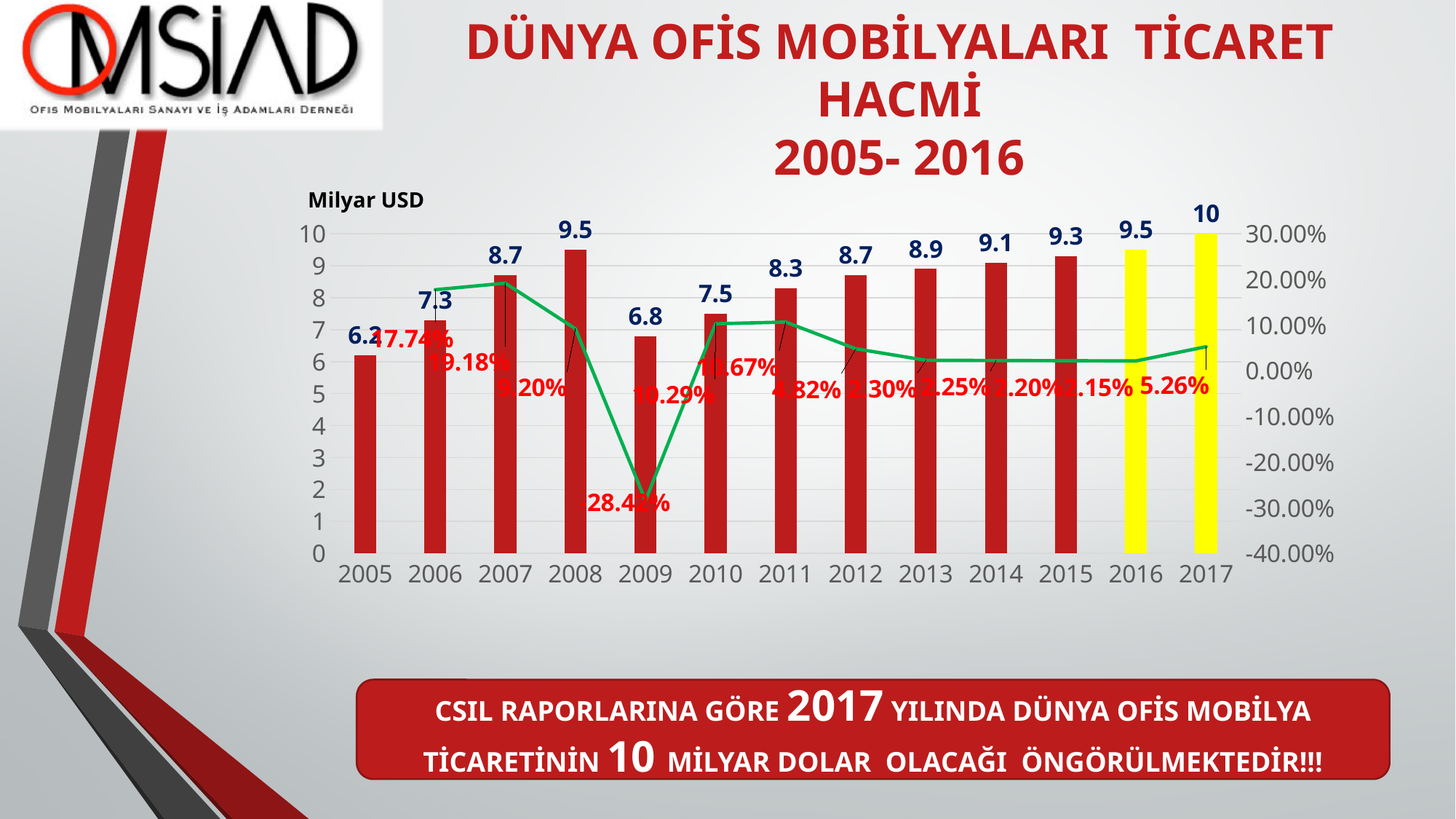
What is the value of the bar for 2012? 8.7 What is the value of the green line at its lowest point, in 2009? -28.42% Which bar is taller, 2011 or 2012? 2012 Which years have yellow bars instead of red? 2016 and 2017 Which year has the lowest bar? 2005 What kind of chart is this? Bar chart with a line series How many years are shown on the x axis? 13 Do the bar values rise or fall from 2009 to 2017? Rise What is the value of the bar for 2017? 10 Which year has the highest bar? 2017 What is the difference between the bar values for 2015 and 2009? 2.5 What is the value of the bar for 2008? 9.5